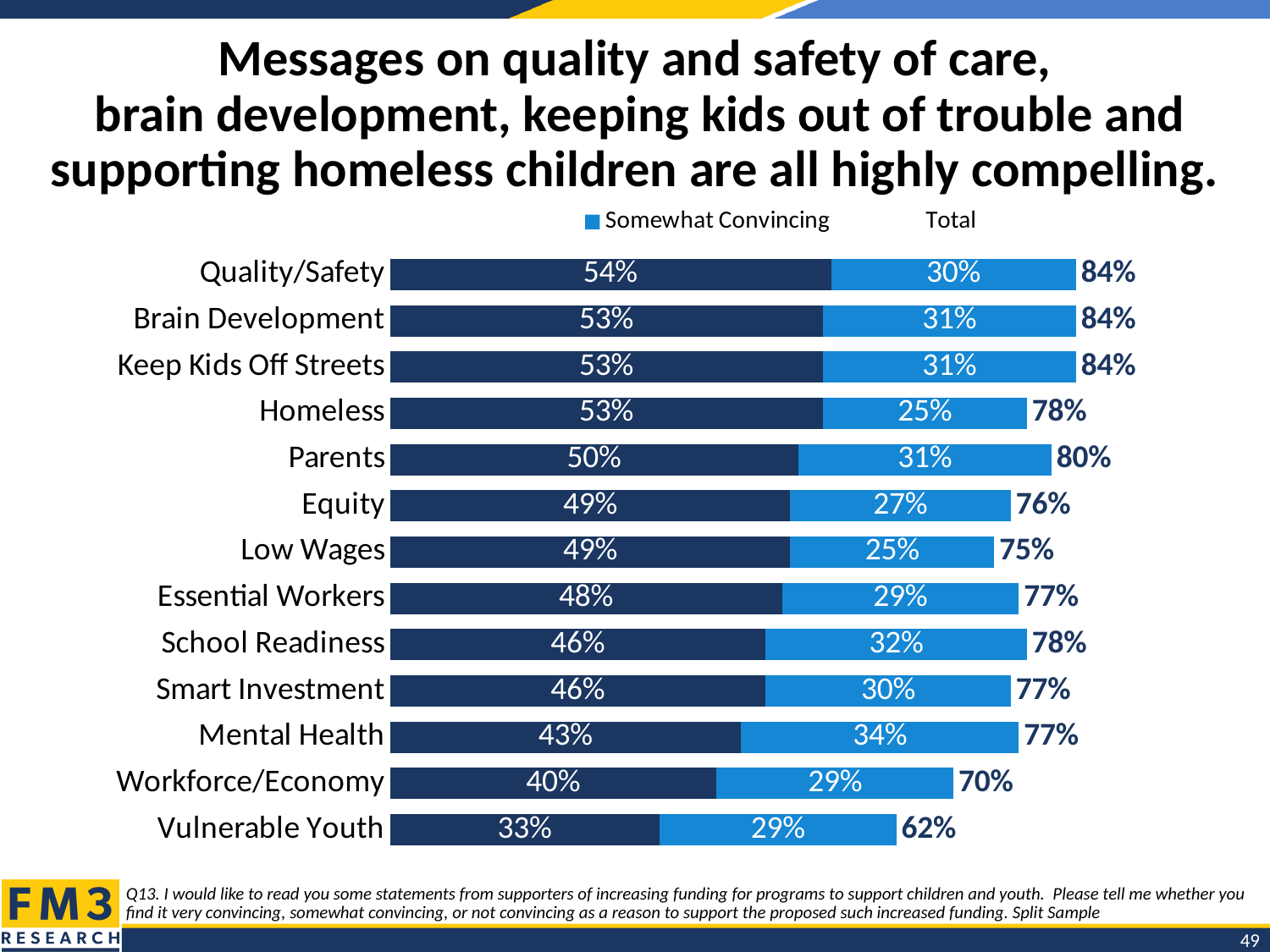
How many categories are shown in the chart? 13 What is the difference between the Somewhat Convincing values for Mental Health and Homeless? 9 percentage points What is the Total shown for Workforce/Economy? 70% What is the Total shown for Homeless? 78% What value is printed in the dark blue segment of the Vulnerable Youth bar? 33% Which category has the highest Somewhat Convincing value? Mental Health Which legend entry is shown with a light blue marker? Somewhat Convincing What kind of chart is shown on the slide? Stacked bar chart What is the Somewhat Convincing value for Mental Health? 34% Which category has the lowest Total? Vulnerable Youth What is the difference between the Total for Quality/Safety and the Total for Vulnerable Youth? 22 percentage points Which has the larger Total, Parents or Equity? Parents